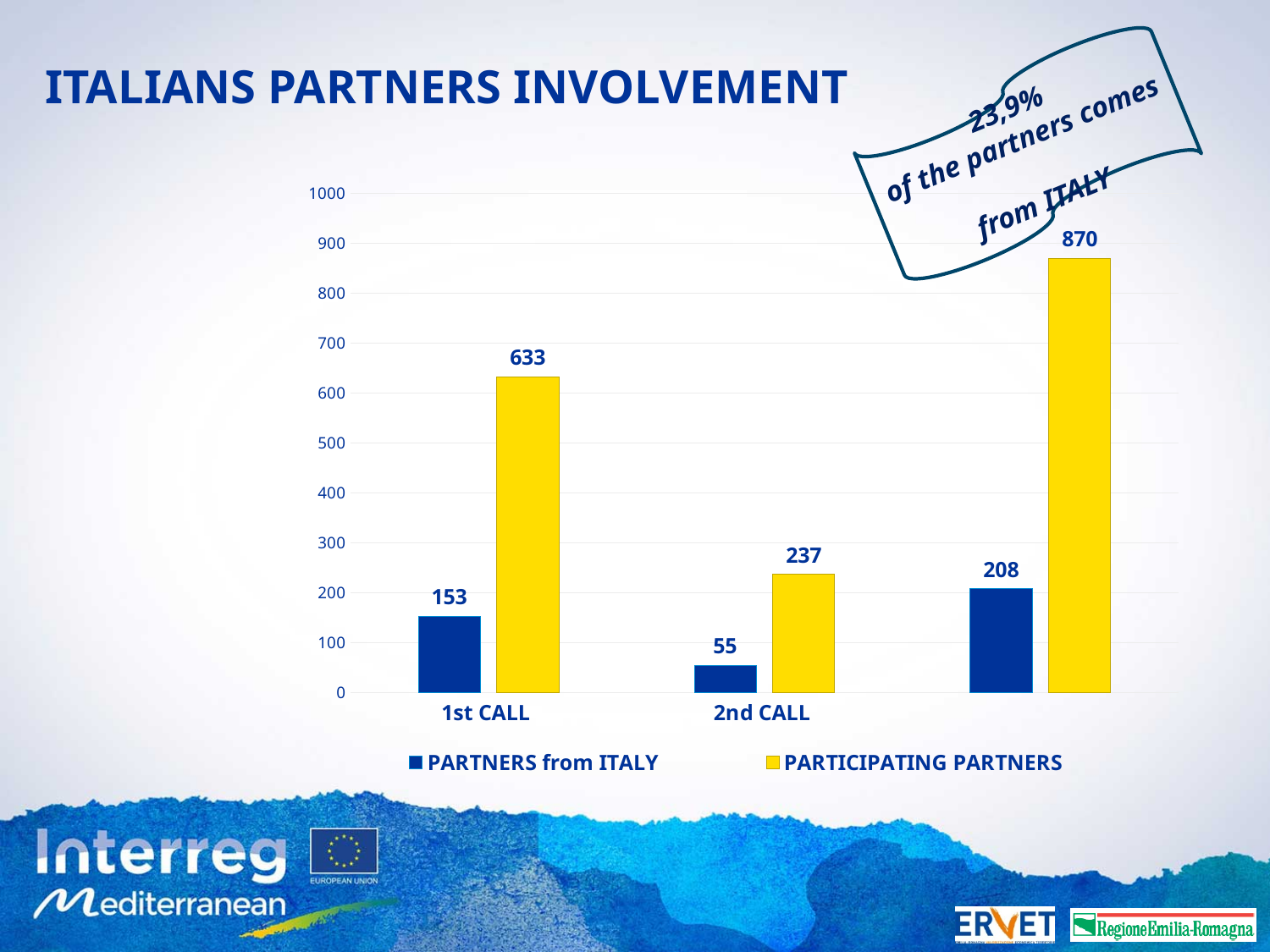
What is the difference between PARTICIPATING PARTNERS and PARTNERS from ITALY in the 1st CALL? 480 How many series does the legend list? 2 What is the value for PARTNERS from ITALY in the 2nd CALL? 55 What is the value for PARTICIPATING PARTNERS in the 1st CALL? 633 What is the value for PARTICIPATING PARTNERS in the 2nd CALL? 237 What is the title of the slide? ITALIANS PARTNERS INVOLVEMENT Which is larger: PARTNERS from ITALY in the 1st CALL or in the 2nd CALL? 1st CALL Is the value for PARTICIPATING PARTNERS in the 2nd CALL greater or less than 300? less What is the lowest value shown for PARTNERS from ITALY? 55 What is the value for PARTNERS from ITALY in the 1st CALL? 153 What is the highest value shown for PARTICIPATING PARTNERS? 870 What kind of chart is shown on the slide? Bar chart